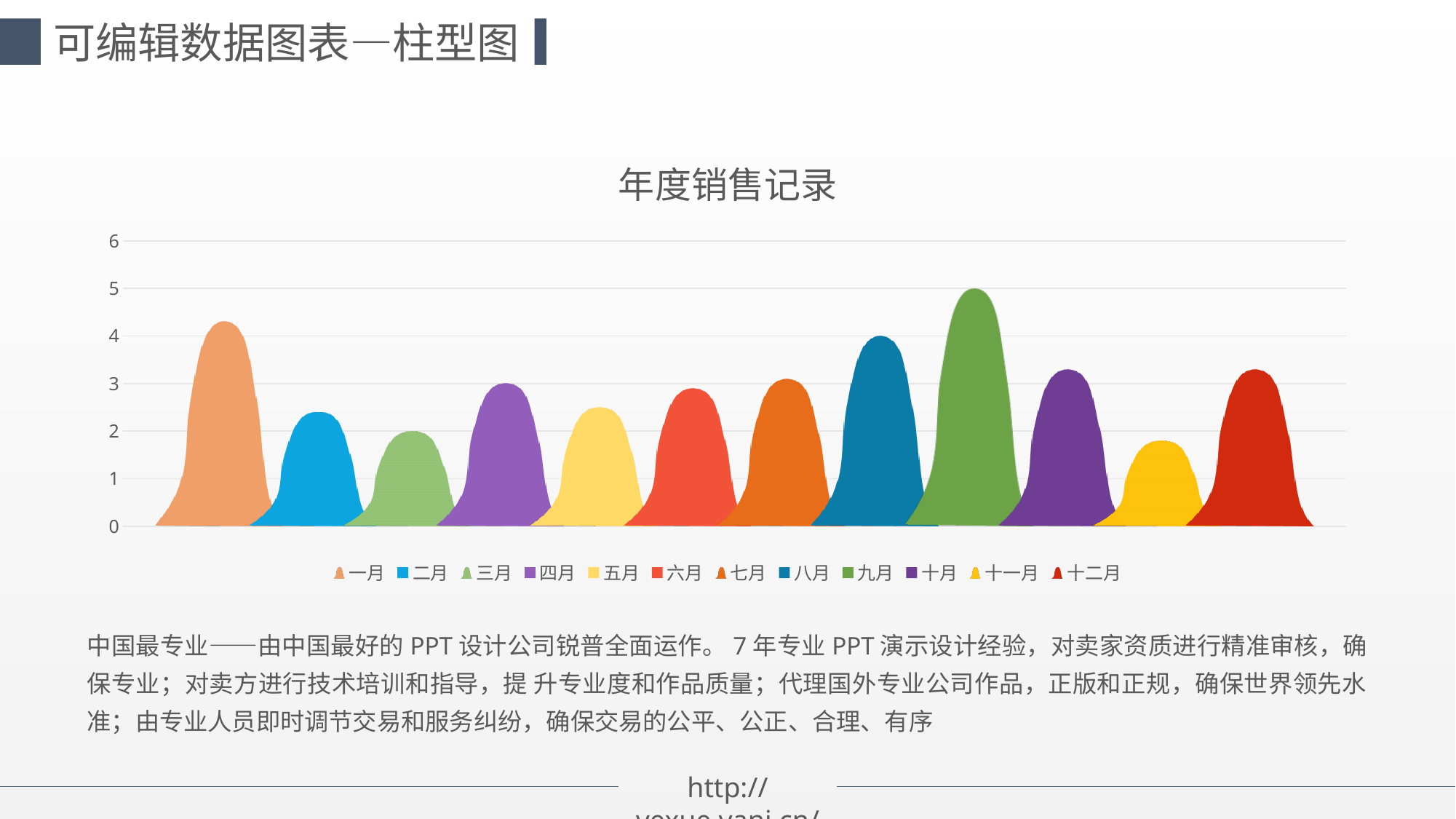
Which is larger, the value for 一月 or 二月? 一月 Which month has the highest value? 九月 Which is larger, the value for 十月 or 十一月? 十月 Is the value for 一月 greater or less than 4? greater Is the value for 十一月 greater or less than 2? less How many series does the legend list? 12 Which is larger, the value for 九月 or 八月? 九月 Is the value for 八月 greater or less than 3? greater What is the title of the chart? 年度销售记录 What is the value for 九月? 5